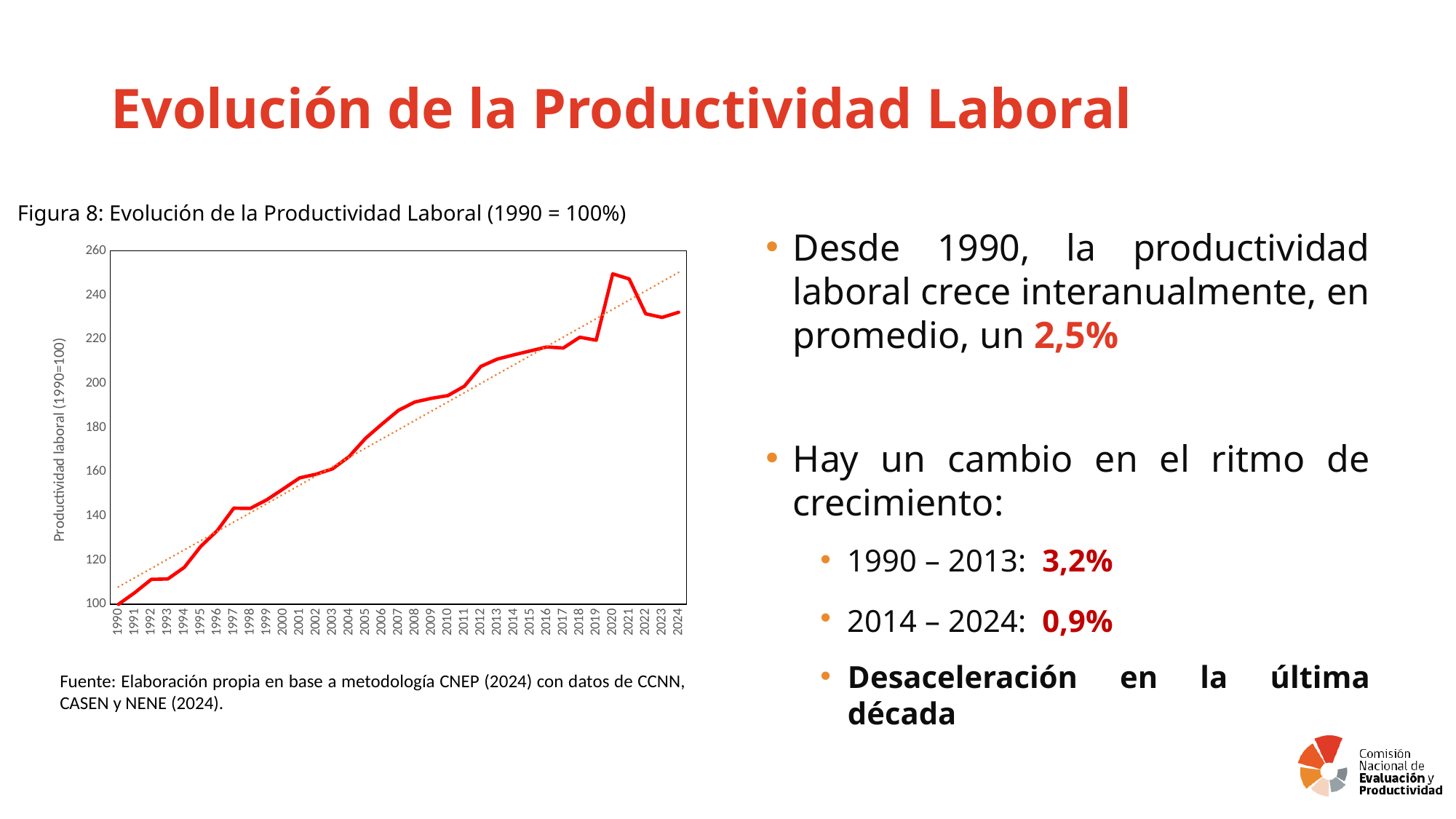
In which year does the line in Figura 8 have its lowest value? 1990 How many years are plotted on the x axis of Figura 8? 35 Is the value for 2000 in Figura 8 greater or less than 160? less Which year has the higher value in Figura 8, 2020 or 2024? 2020 In which year does the line in Figura 8 reach its highest value? 2020 Does labour productivity in Figura 8 generally rise or fall from 1990 to 2024? rise Is the value for 2024 in Figura 8 greater or less than 220? greater Is the value for 2020 in Figura 8 greater or less than 240? greater What is the label of the y axis in Figura 8? Productividad laboral (1990=100) What kind of chart is shown in Figura 8? line chart What is the value of labour productivity in 1990 in Figura 8? 100